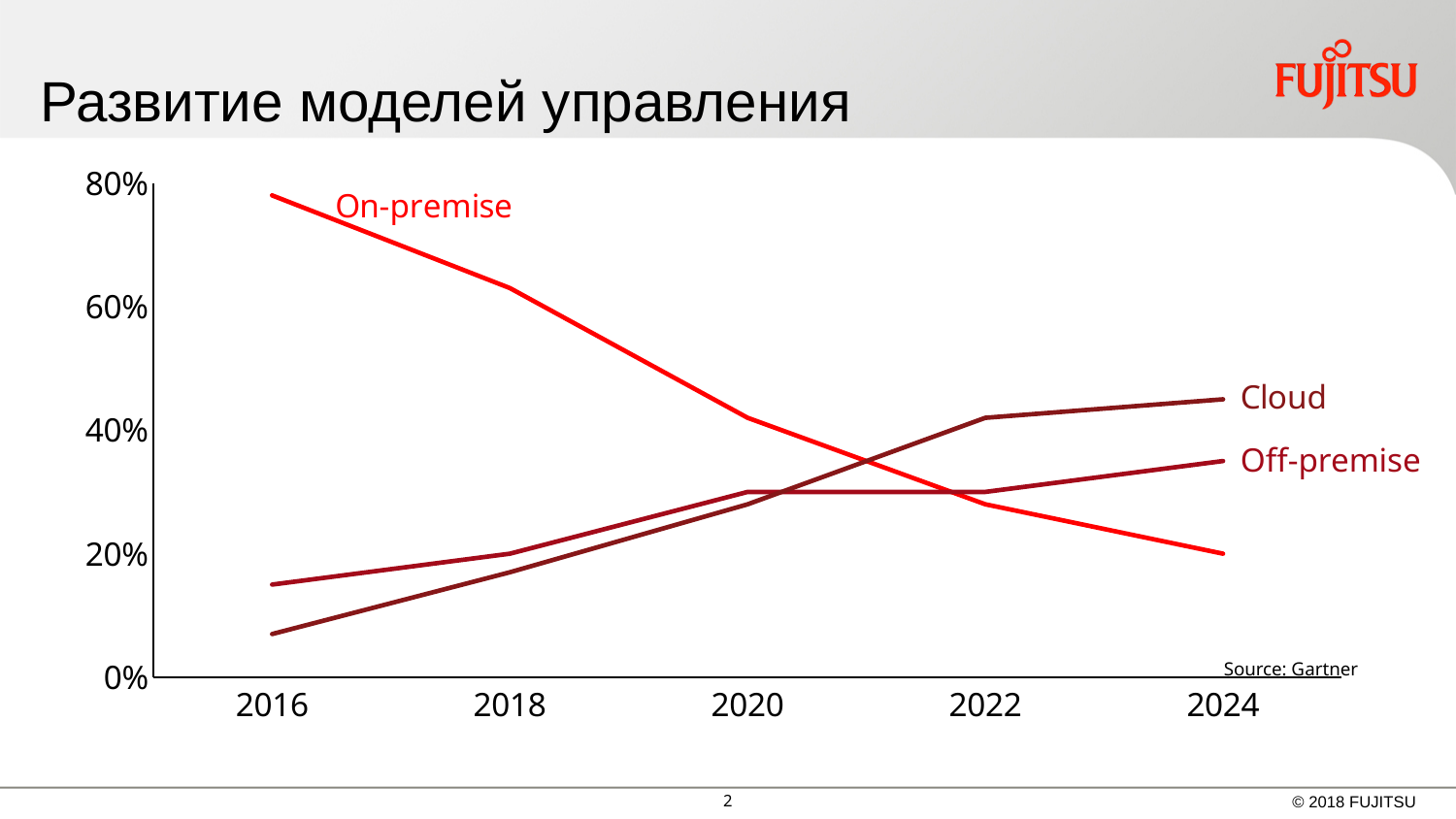
How many years are labelled on the x axis of the chart? 5 Is the value for On-premise in 2016 greater or less than 60%? greater How many series are plotted on the chart? 3 Is the value for On-premise in 2024 greater or less than 40%? less Is the value for Cloud in 2024 greater or less than 40%? greater Which series has the highest value in 2016? On-premise What kind of chart is shown on the slide? line chart Does the On-premise line rise or fall from 2016 to 2024? fall In 2024, which is larger: Cloud or Off-premise? Cloud Which series has the lowest value in 2016? Cloud Does the Cloud line rise or fall from 2016 to 2024? rise